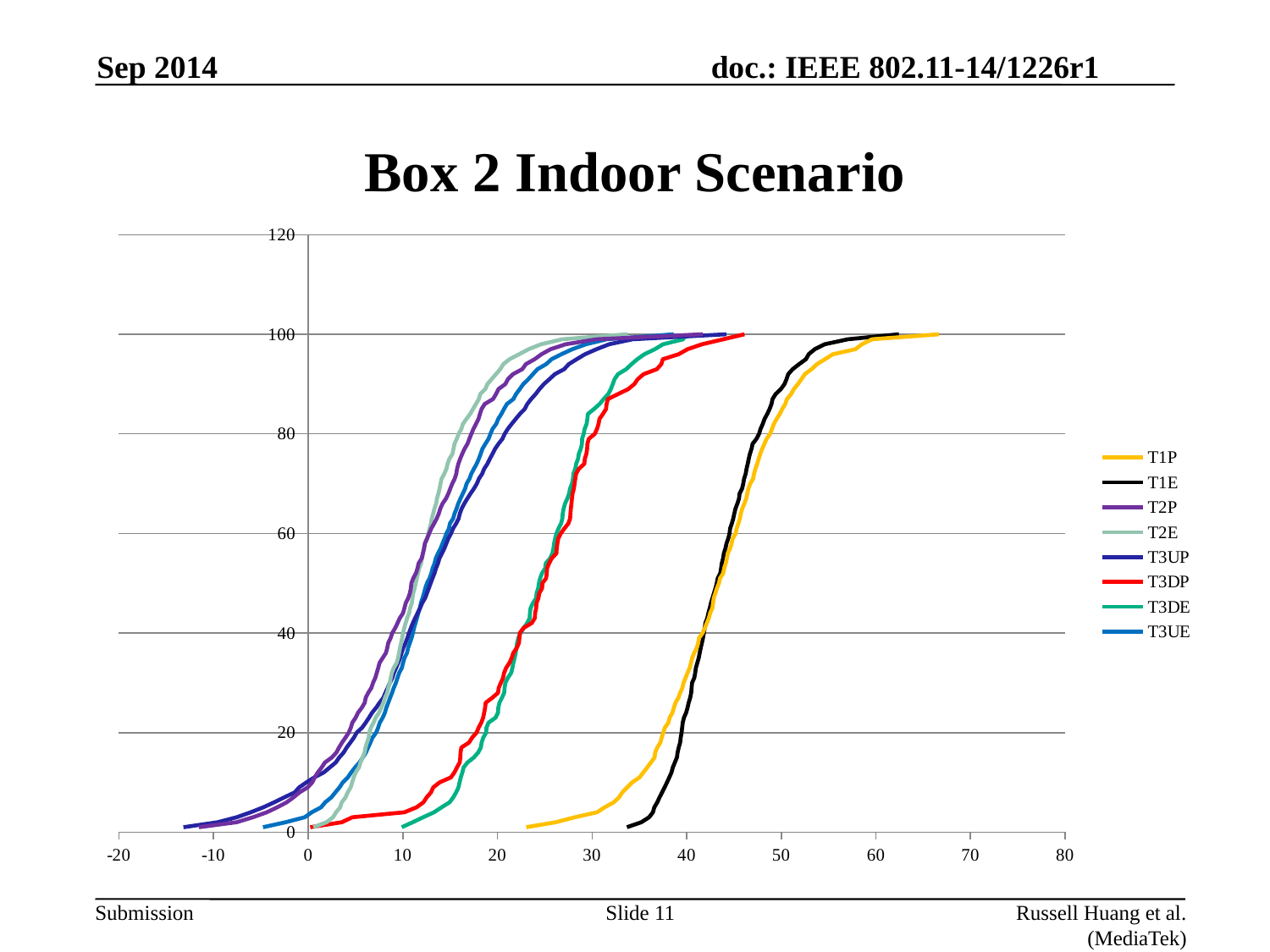
Is the value of T1E at x = 50 greater or less than 80? greater What is the title of the chart? Box 2 Indoor Scenario At x = 10, which series has the higher value, T2E or T3DP? T2E What kind of chart is shown on the slide? line chart Is the value of T1P at x = 40 greater or less than 40? less At x = 40, which series has the higher value, T1P or T1E? T1P How many series does the legend list? 8 Do the values of the series rise or fall as x increases? rise Is the value of T2E at x = 20 greater or less than 80? greater What colour is the T1E line? black Which series reaches 100 at the highest x value? T1P